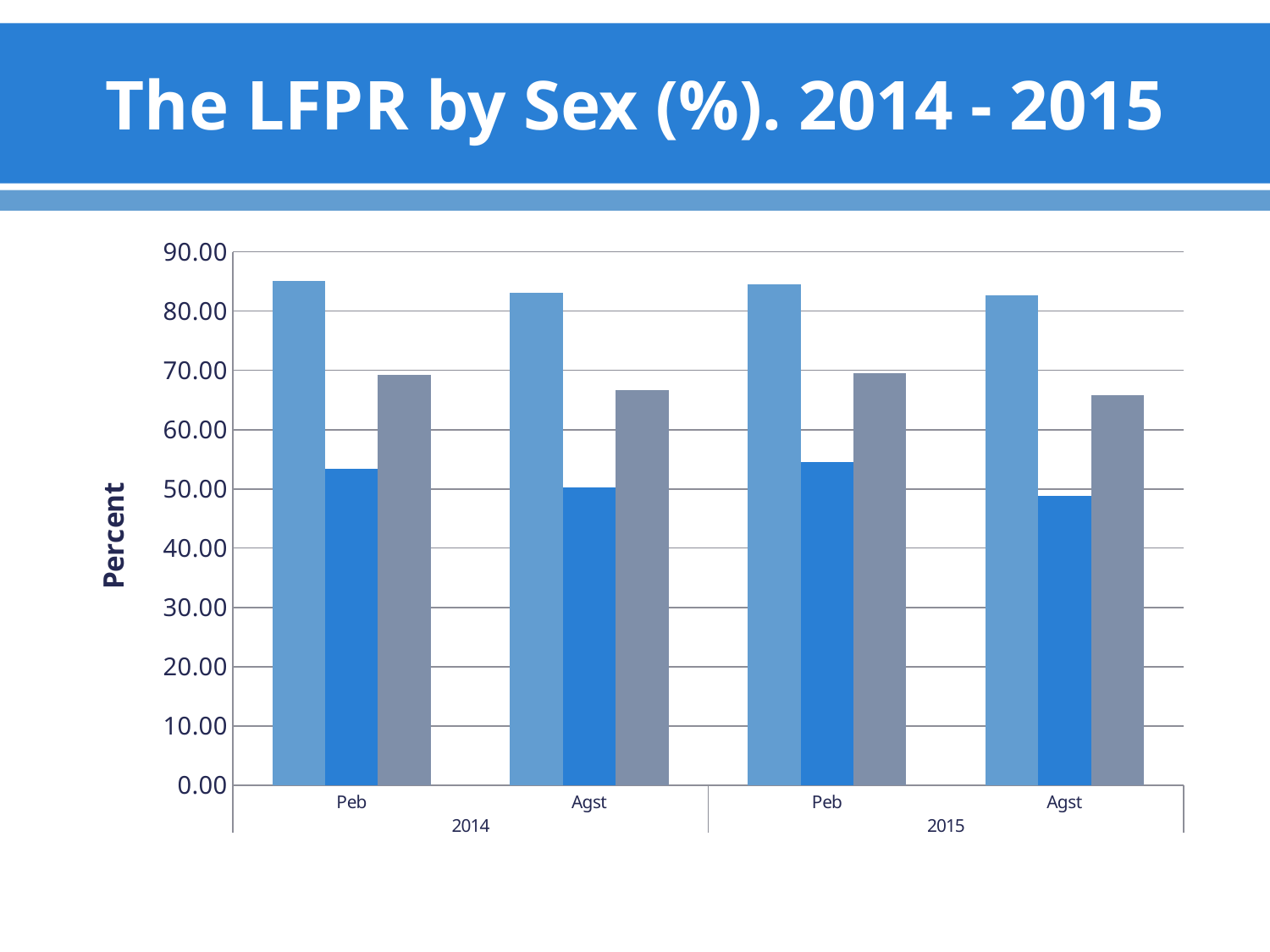
Is the value of the grey bar for Agst 2014 greater or less than 70.00? less Within each period, which bar is the shortest: the light blue, dark blue, or grey bar? the dark blue bar Is the value of the grey bar for Peb 2015 greater or less than 60.00? greater Is the value of the dark blue bar for Agst 2015 greater or less than 50.00? less Which grey bar is taller: Peb 2015 or Agst 2015? Peb 2015 How many period categories (month groups) are shown along the x axis? 4 What is the title of the chart? The LFPR by Sex (%). 2014 - 2015 What is the label on the vertical axis of the chart? Percent In Agst 2014, which bar is taller: the light blue bar or the dark blue bar? the light blue bar What kind of chart is shown on the slide? bar chart